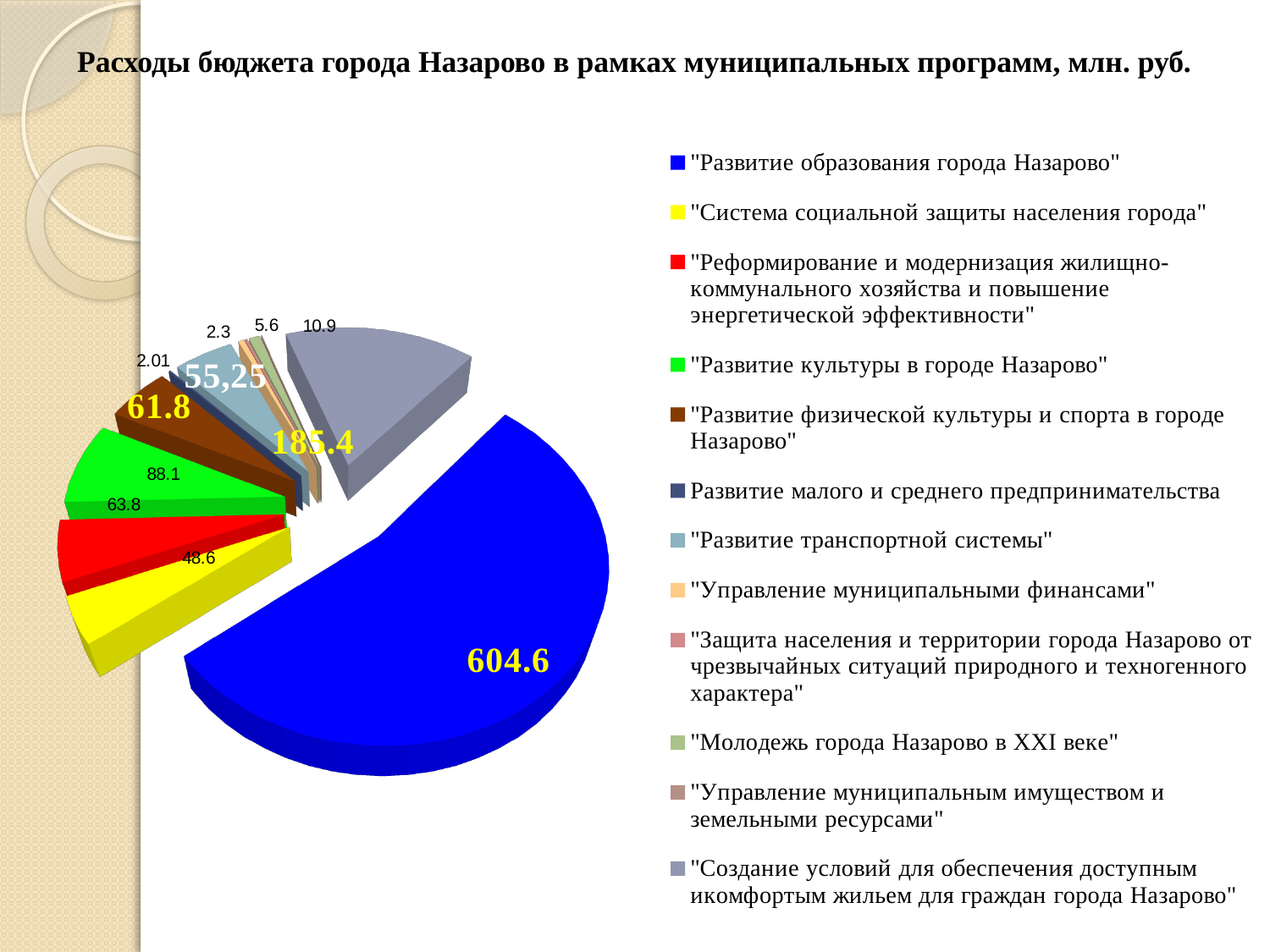
Which program has the smallest labelled value? Развитие малого и среднего предпринимательства How many categories does the legend list? 12 What is the value for "Развитие физической культуры и спорта в городе Назарово"? 61.8 Which program has the largest share of the budget expenses? "Развитие образования города Назарово" What is the title of the chart? Расходы бюджета города Назарово в рамках муниципальных программ, млн. руб. What is the value for "Развитие транспортной системы"? 55,25 What is the value for "Система социальной защиты населения города"? 48.6 What is the value for "Развитие культуры в городе Назарово"? 88.1 What type of chart is shown on the slide? pie chart What is the value for "Развитие образования города Назарово"? 604.6 Which is larger: the value for "Развитие культуры в городе Назарово" or for "Реформирование и модернизация жилищно-коммунального хозяйства и повышение энергетической эффективности"? "Развитие культуры в городе Назарово" What is the difference between the value for "Развитие образования города Назарово" and the value for "Создание условий для обеспечения доступным и комфортным жильем для граждан города Назарово"? 419.2